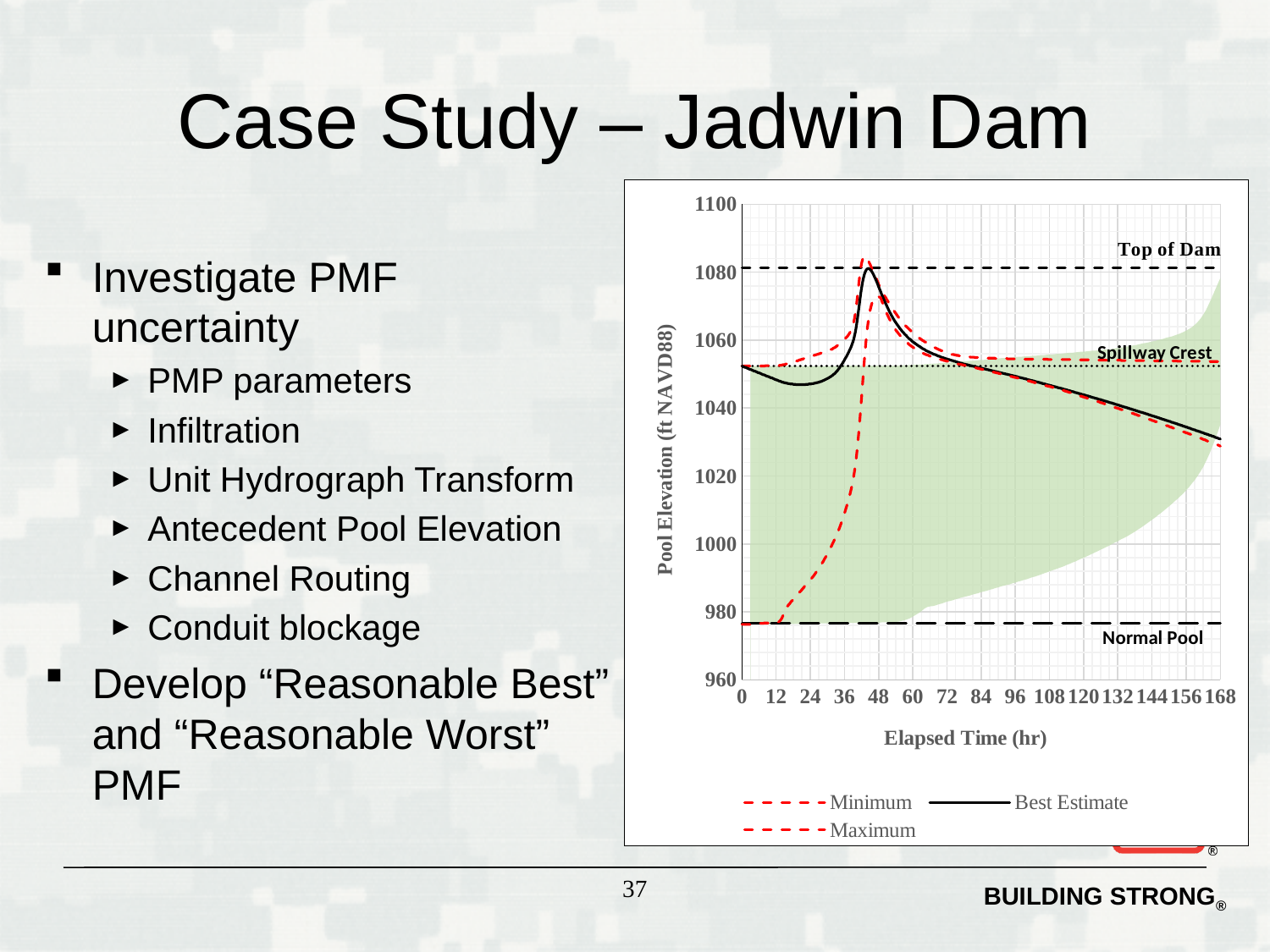
At 168 hr, which series has the higher pool elevation, Maximum or Best Estimate? Maximum What kind of chart is shown on the slide? line chart What is the title of the chart's vertical axis? Pool Elevation (ft NAVD88) At 24 hr, which series has the higher pool elevation, Best Estimate or Minimum? Best Estimate Is the Minimum pool elevation at 24 hr greater or less than 1000? less How many tick labels are shown on the Elapsed Time (hr) axis? 15 How many series does the chart legend list? 3 Does the Best Estimate pool elevation rise or fall between 48 hr and 168 hr? fall Is the Best Estimate pool elevation at 0 hr greater or less than 1040? greater Is the Best Estimate pool elevation at 168 hr greater or less than 1040? less What are the series names listed in the chart legend? Minimum, Best Estimate, Maximum